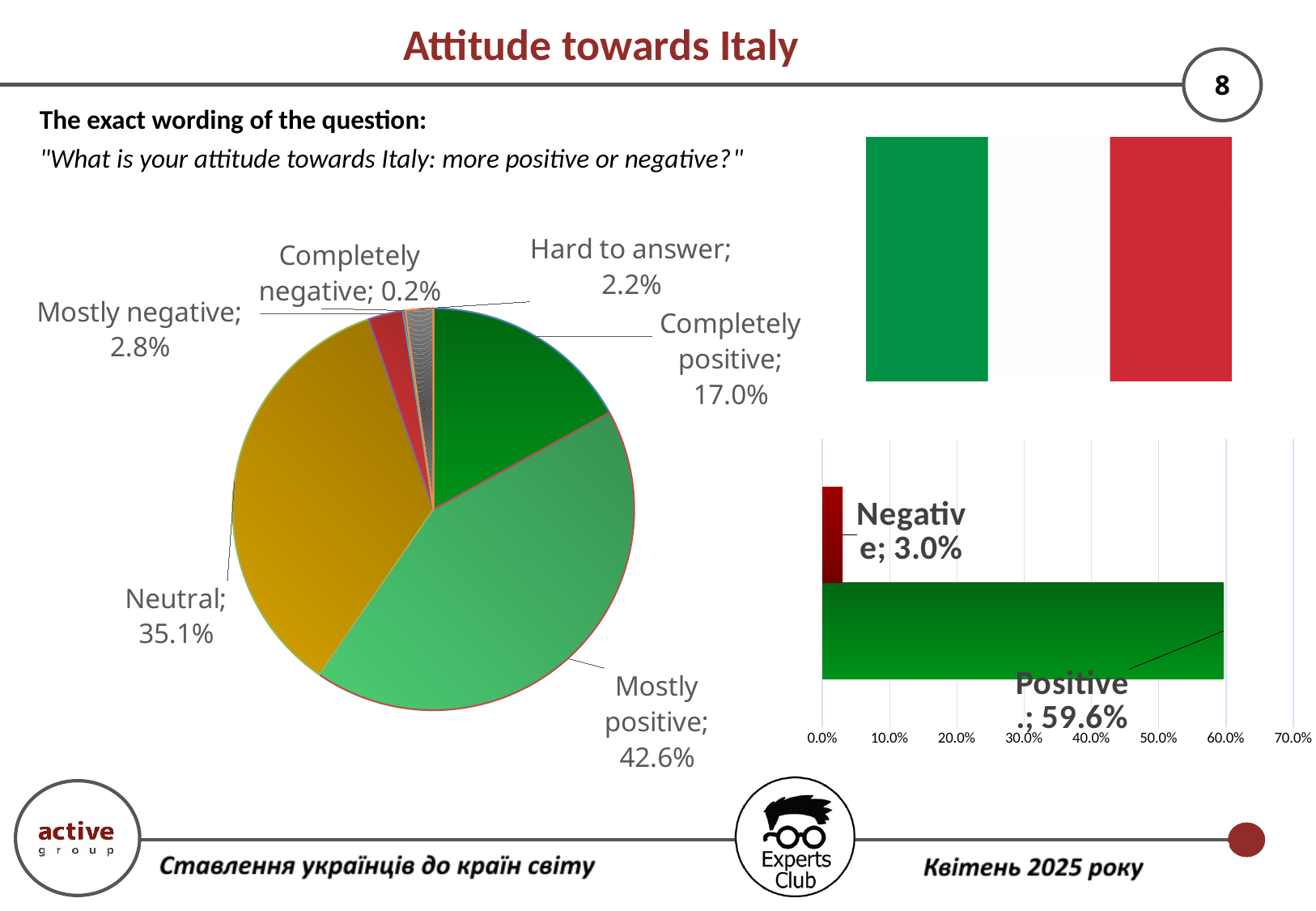
What type of chart is shown on the right side of the slide below the flag? Bar chart In the pie chart, how many slices are there? 6 In the pie chart, which category has the largest slice? Mostly positive In the pie chart, what share is labelled for Completely positive? 17.0% In the pie chart, what share is labelled for Neutral? 35.1% In the bar chart on the right, what is the value for Negative? 3.0% In the pie chart, what share is labelled for Mostly positive? 42.6% In the bar chart on the right, what is the value for Positive? 59.6% In the pie chart, which category has the smallest slice? Completely negative In the pie chart, what share is labelled for Hard to answer? 2.2% In the pie chart, what is the difference between the Mostly positive and Neutral shares? 7.5% In the pie chart, which is larger: Mostly negative or Hard to answer? Mostly negative